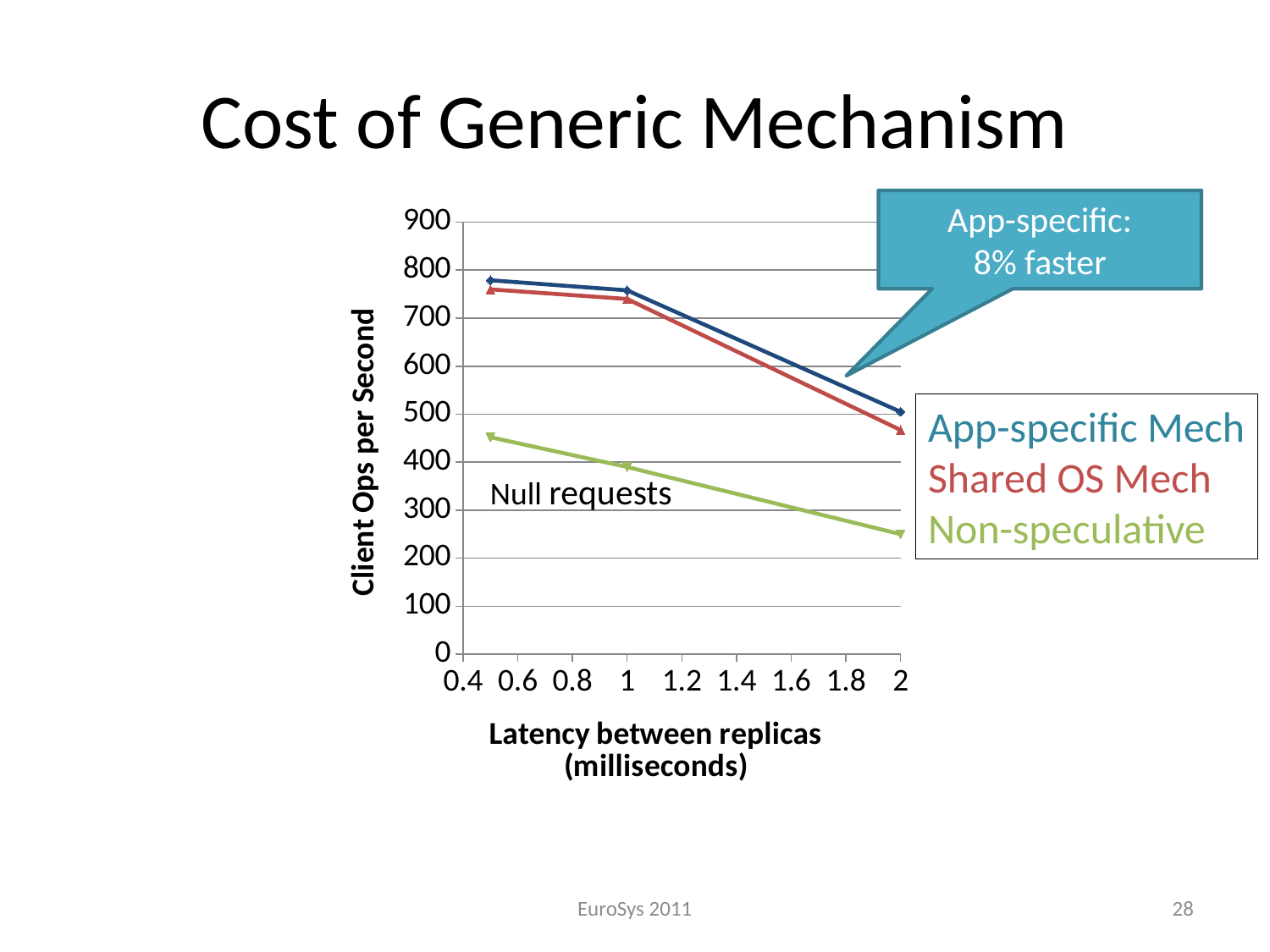
Do the values for the Non-speculative series rise or fall as latency between replicas increases? fall What kind of chart is shown on the slide? line chart Is the value for App-specific Mech at 2 milliseconds latency greater or less than 600? less Is the value for Shared OS Mech at 0.5 milliseconds latency greater or less than 700? greater What is the label of the y axis? Client Ops per Second What is the title of the slide's chart? Cost of Generic Mechanism Is the value for Non-speculative at 2 milliseconds latency greater or less than 300? less Do the values for the App-specific Mech series rise or fall as latency between replicas increases? fall How many series does the legend list? 3 At 1 millisecond latency, which is larger: Shared OS Mech or Non-speculative? Shared OS Mech How many data points are plotted for each series? 3 Which series has the lowest client ops per second across all latencies? Non-speculative